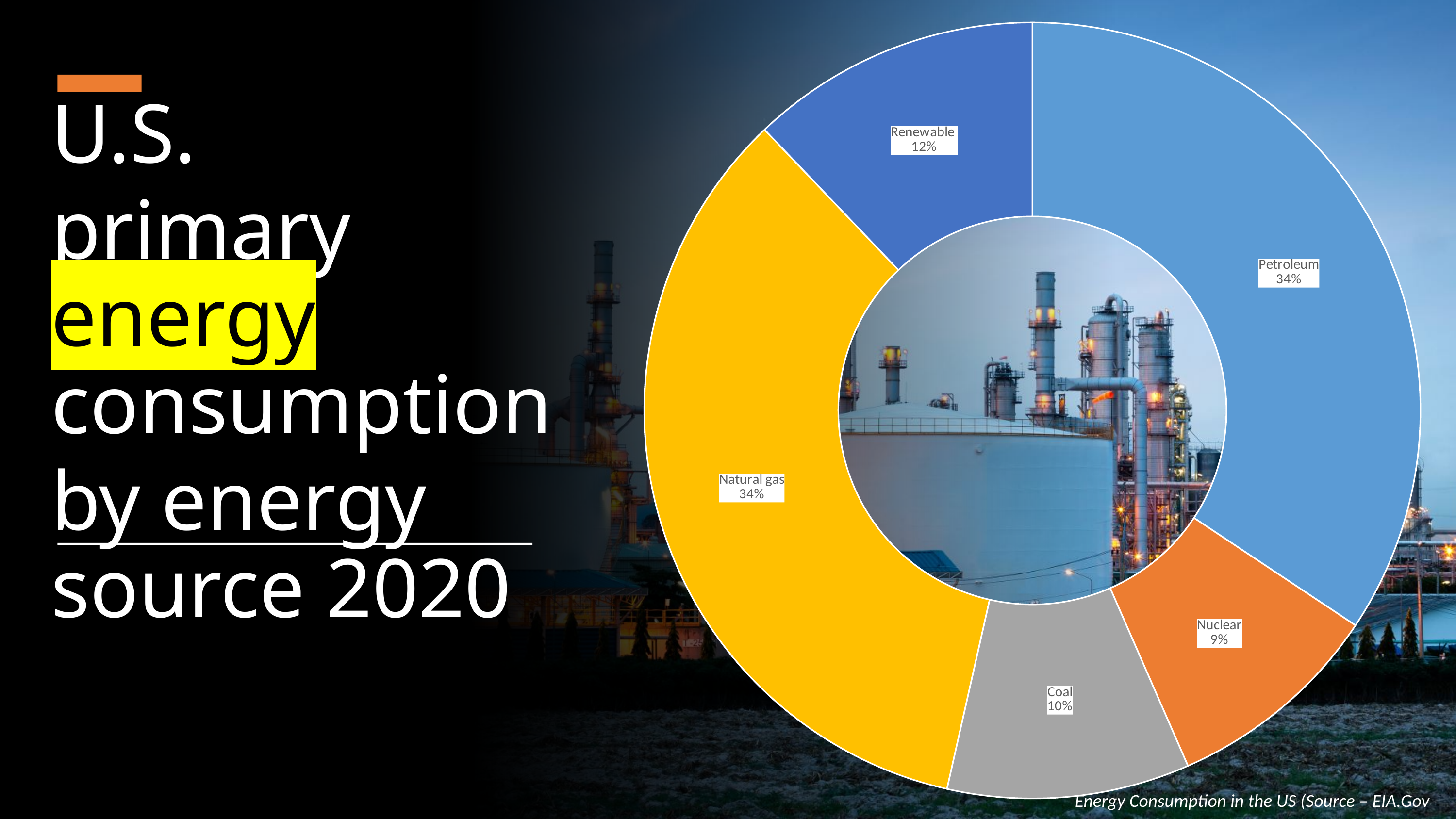
Which energy source has the smallest share in the chart? Nuclear What kind of chart is shown on the slide? Doughnut chart What percentage is shown for Natural gas? 34% Which is larger, the share for Coal or the share for Nuclear? Coal What is the title of the slide containing the chart? U.S. primary energy consumption by energy source 2020 What is the difference in percentage points between Petroleum and Renewable? 22 What is the difference in percentage points between Renewable and Coal? 2 What percentage is shown for Renewable? 12% What percentage is shown for Nuclear? 9% What share of U.S. primary energy consumption in 2020 does Petroleum account for? 34% How many energy sources are shown in the chart? 5 What percentage is shown for Coal? 10%